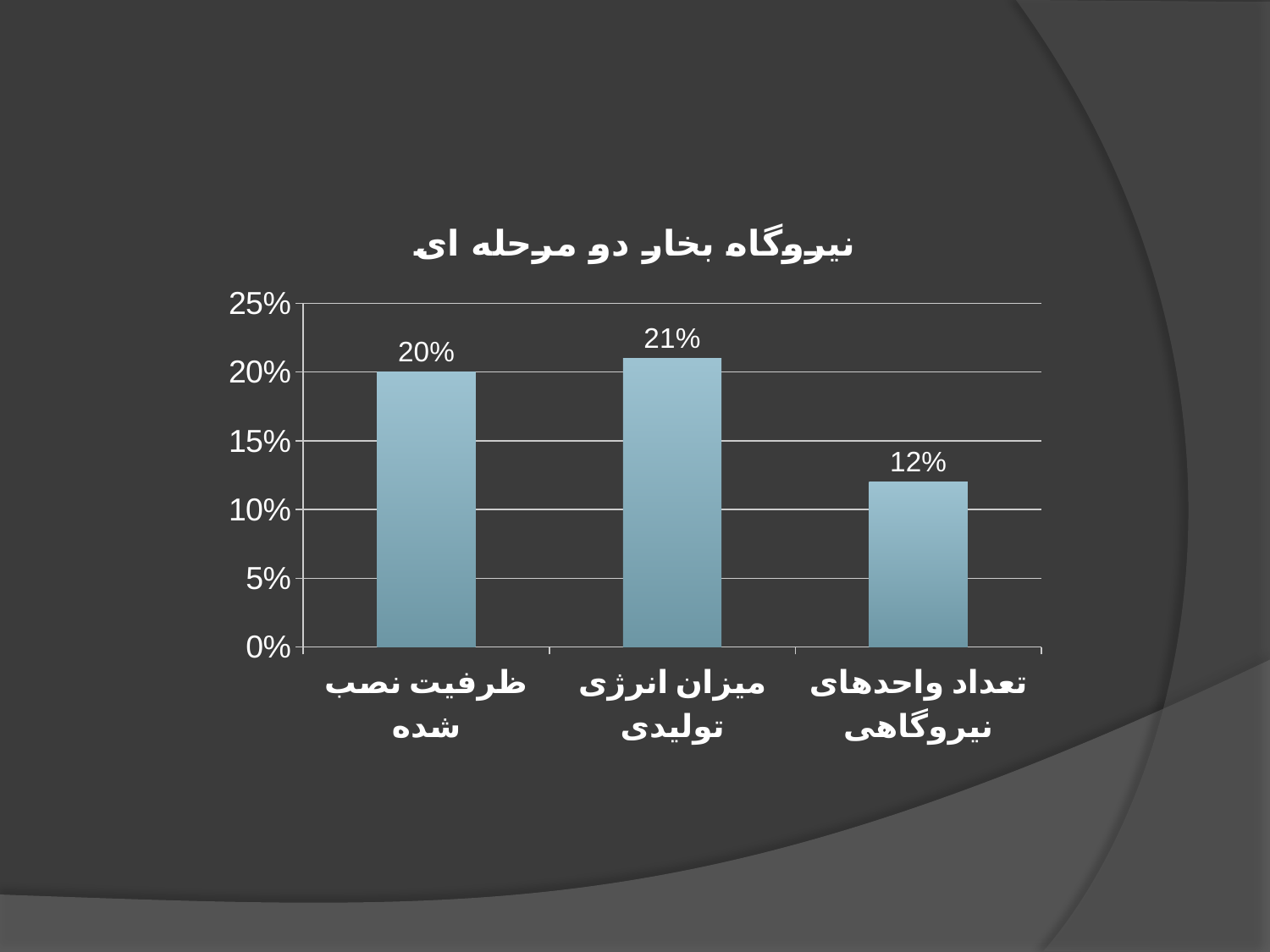
Is the value for تعداد واحدهای نیروگاهی greater or less than 15%? less How many categories are shown on the x axis? 3 What kind of chart is shown on the slide? bar chart What is the value for ظرفیت نصب شده? 20% What is the value for میزان انرژی تولیدی? 21% Which is larger, the value for ظرفیت نصب شده or the value for تعداد واحدهای نیروگاهی? ظرفیت نصب شده What is the value for تعداد واحدهای نیروگاهی? 12% Which category has the highest value? میزان انرژی تولیدی Which category has the lowest value? تعداد واحدهای نیروگاهی What is the difference between the values for ظرفیت نصب شده and تعداد واحدهای نیروگاهی? 8% What is the difference between the values for میزان انرژی تولیدی and تعداد واحدهای نیروگاهی? 9% What is the title of the chart? نیروگاه بخار دو مرحله ای